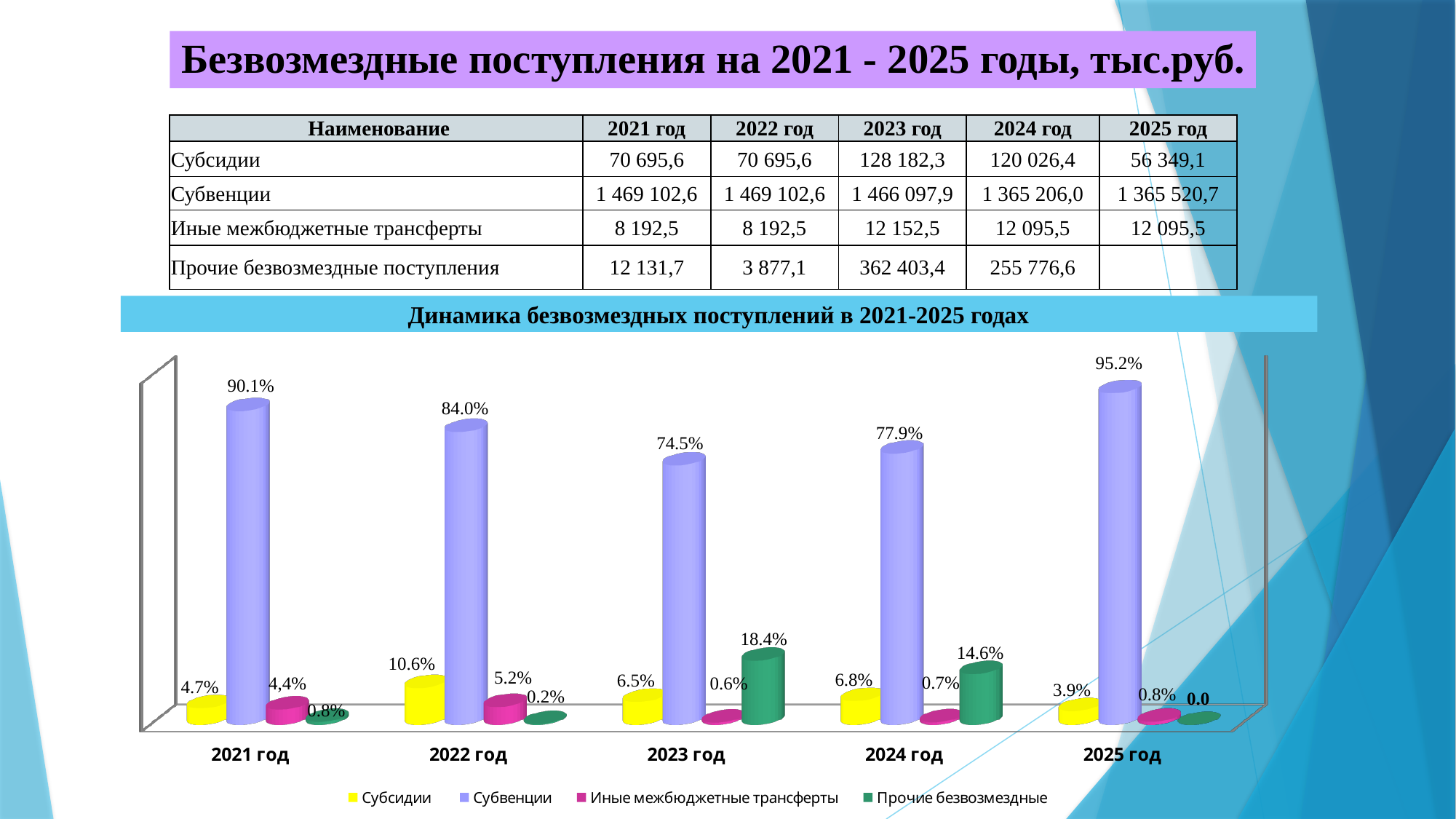
What is the value for Субвенции in 2021 год on the chart? 90.1% In which year is the value for Субвенции the lowest on the chart? 2023 год What is the value for Прочие безвозмездные in 2023 год on the chart? 18.4% Which colour represents Субсидии in the chart legend? Yellow What type of chart is shown under the title 'Динамика безвозмездных поступлений в 2021-2025 годах'? Bar chart In which year is the value for Субвенции the highest on the chart? 2025 год What is the value for Субсидии in 2022 год on the chart? 10.6% Which is larger on the chart: Прочие безвозмездные in 2023 год or in 2024 год? 2023 год How many series does the legend of the chart list? 4 What is the value for Иные межбюджетные трансферты in 2022 год on the chart? 5.2% What is the difference between the Субвенции values for 2025 год and 2024 год on the chart? 17.3% How many year categories are shown on the x axis of the chart? 5